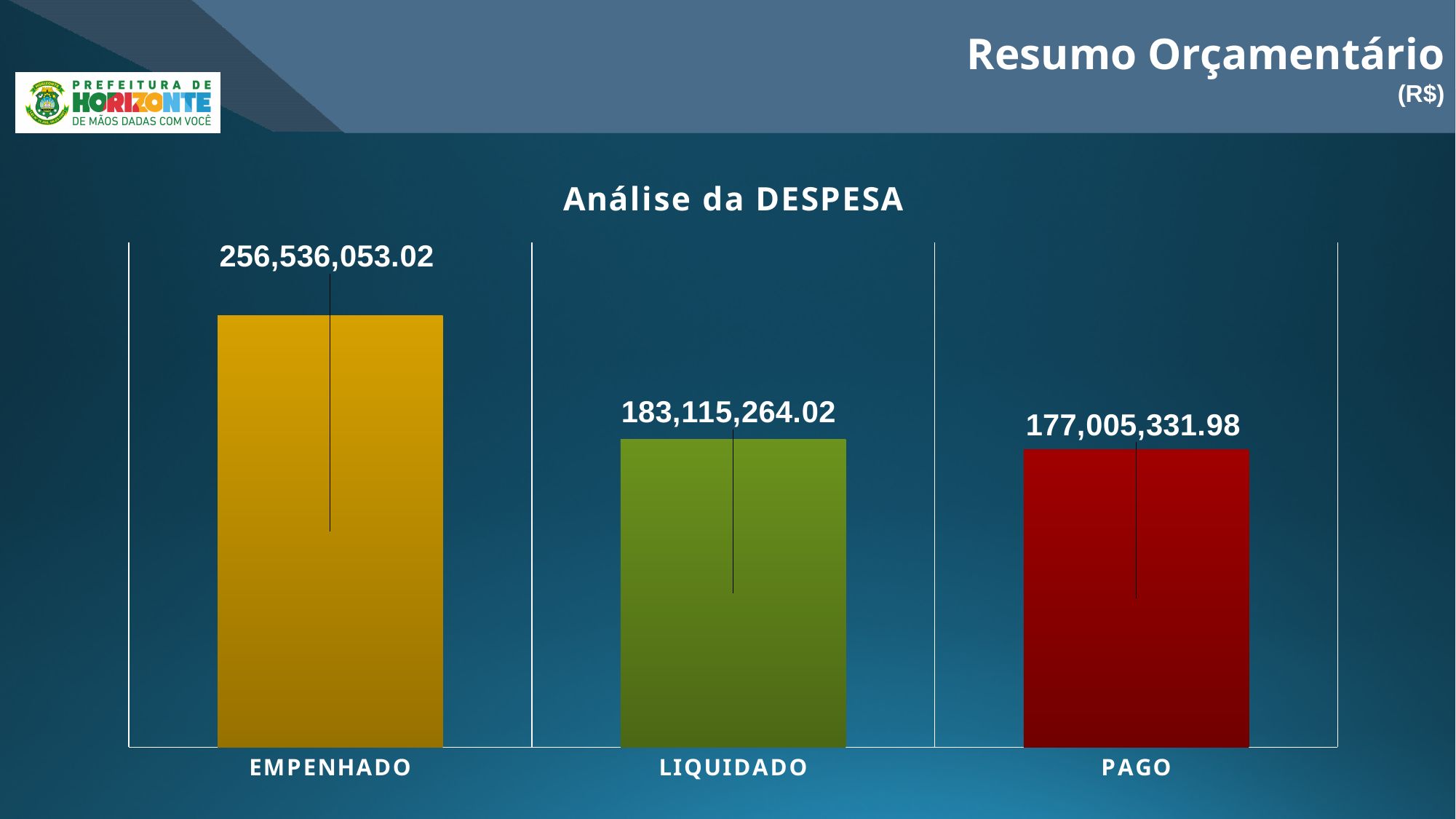
Do the values rise or fall from left to right across the categories? Fall What is the difference between the LIQUIDADO and PAGO values? 6,109,932.04 What is the title of the chart? Análise da DESPESA What is the value for LIQUIDADO? 183,115,264.02 Which is larger, the value for EMPENHADO or the value for PAGO? EMPENHADO What is the value for PAGO? 177,005,331.98 What is the difference between the EMPENHADO and LIQUIDADO values? 73,420,789.00 What is the value for EMPENHADO? 256,536,053.02 Which category has the highest value? EMPENHADO What kind of chart is shown on the slide? Bar chart How many categories are shown in the chart? 3 Which category has the lowest value? PAGO